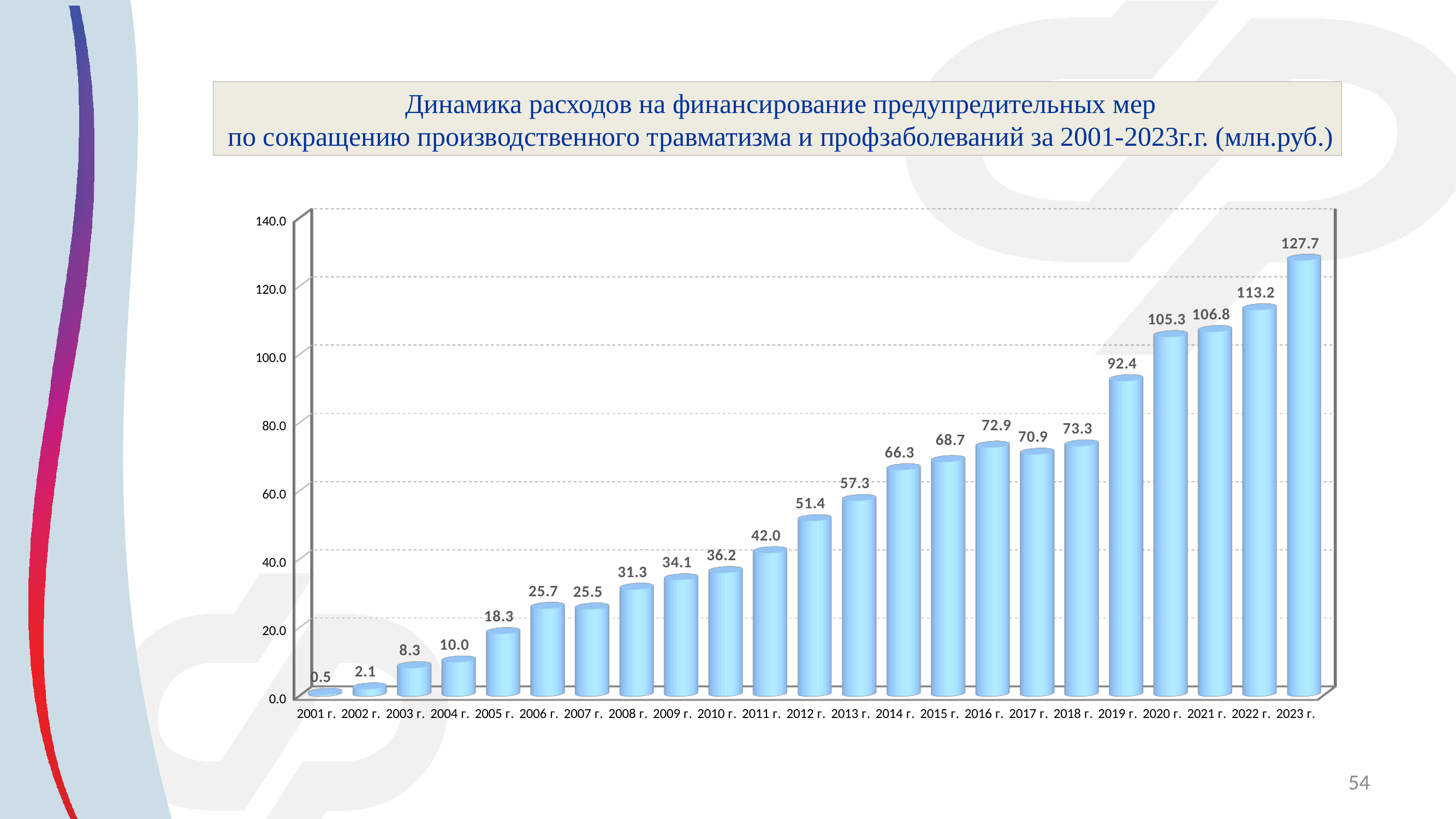
How many years are shown on the x axis? 23 What kind of chart is shown on the slide? bar chart What is the value for 2023 г.? 127.7 Which year has the lowest value? 2001 г. Which year has the highest value? 2023 г. What is the value for 2011 г.? 42.0 What is the difference between the values for 2023 г. and 2022 г.? 14.5 Do the values generally rise or fall from 2001 г. to 2023 г.? rise Which is larger, the value for 2016 г. or the value for 2017 г.? 2016 г. What is the difference between the values for 2020 г. and 2019 г.? 12.9 Is the value for 2013 г. greater or less than 60.0? less What is the value for 2019 г.? 92.4